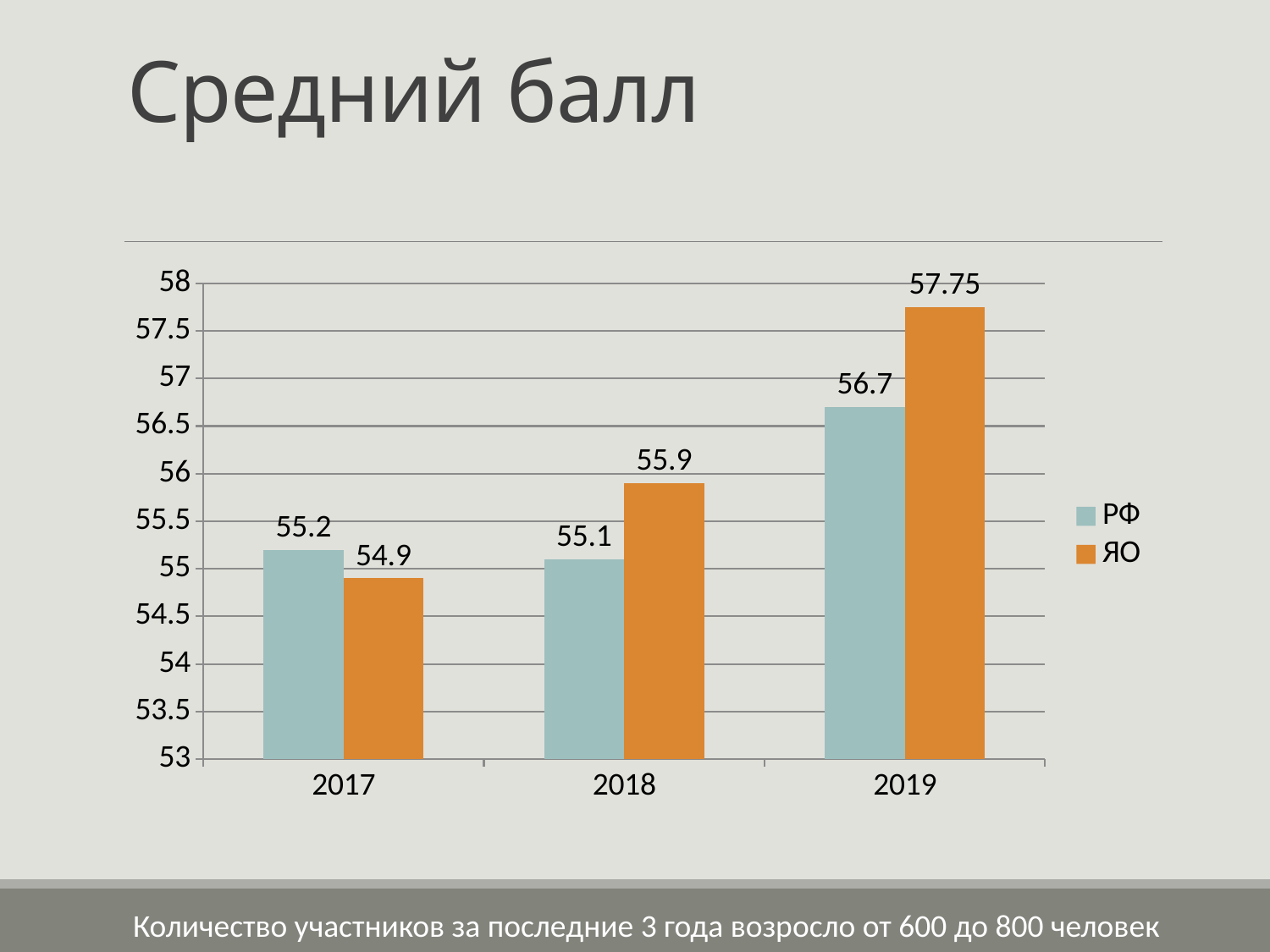
How many years are shown on the x axis? 3 What is the value for ЯО in 2018? 55.9 Does the ЯО value rise or fall from 2017 to 2019? rise What is the value for РФ in 2017? 55.2 How many series does the legend list? 2 Which is larger in 2017, РФ or ЯО? РФ In which year is the ЯО value highest? 2019 What is the value for ЯО in 2019? 57.75 What is the difference between ЯО and РФ in 2019? 1.05 What kind of chart is shown on the slide? bar chart Is the value for ЯО in 2019 greater or less than 57.5? greater In which year is the РФ value lowest? 2018